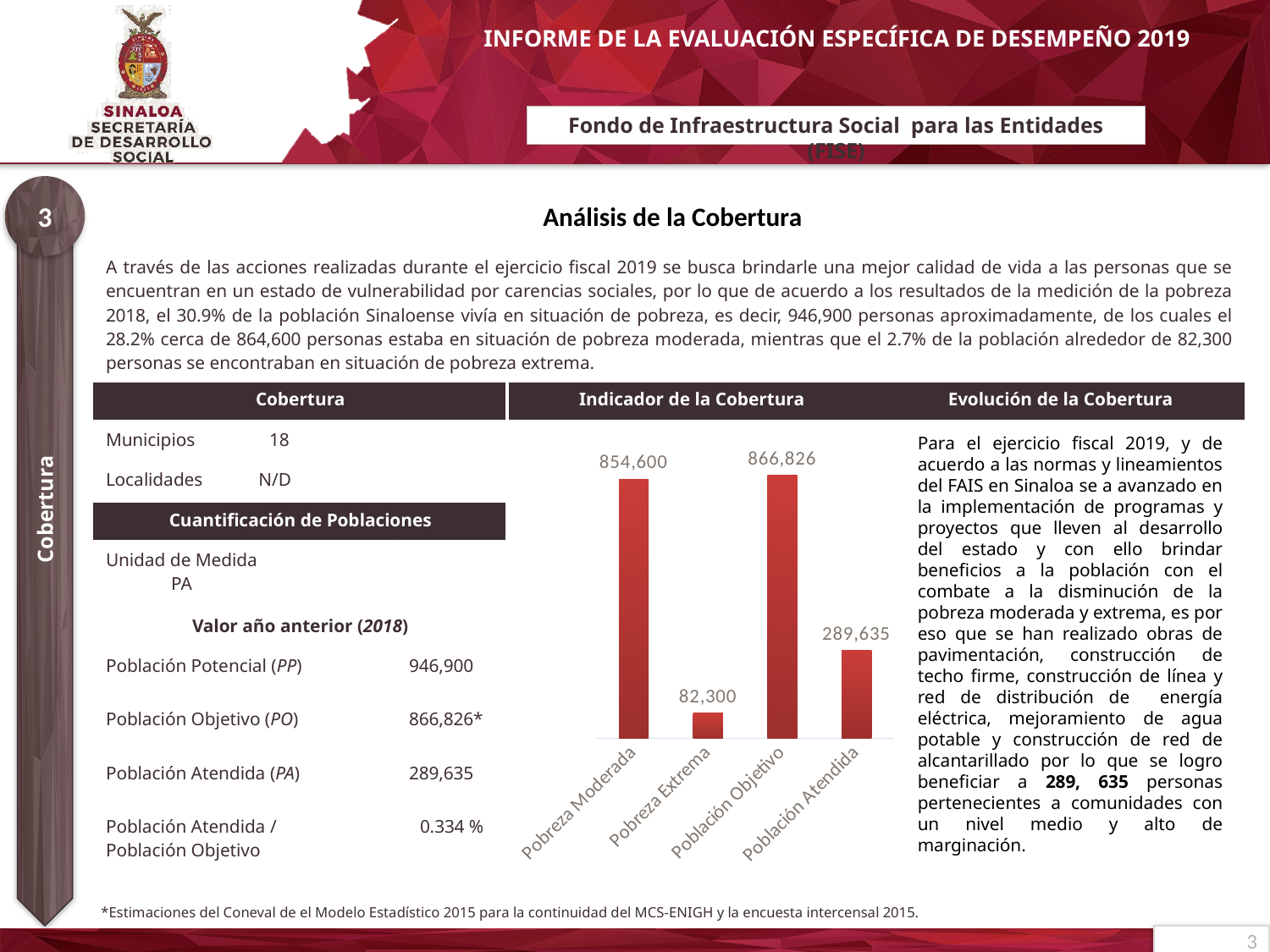
What is the value shown for Pobreza Moderada in the chart? 854,600 What is the difference between the values for Población Objetivo and Pobreza Moderada? 12,226 What is the value shown for Pobreza Extrema in the chart? 82,300 Which category has the lowest value in the chart? Pobreza Extrema Which is larger, the value for Pobreza Moderada or the value for Población Atendida? Pobreza Moderada How many categories are plotted in the chart? 4 What is the difference between the values for Población Atendida and Pobreza Extrema? 207,335 What is the value shown for Población Objetivo in the chart? 866,826 What kind of chart is shown under 'Indicador de la Cobertura'? Bar chart What is the value shown for Población Atendida in the chart? 289,635 What is the difference between the values for Población Objetivo and Población Atendida? 577,191 Which category has the highest value in the chart? Población Objetivo